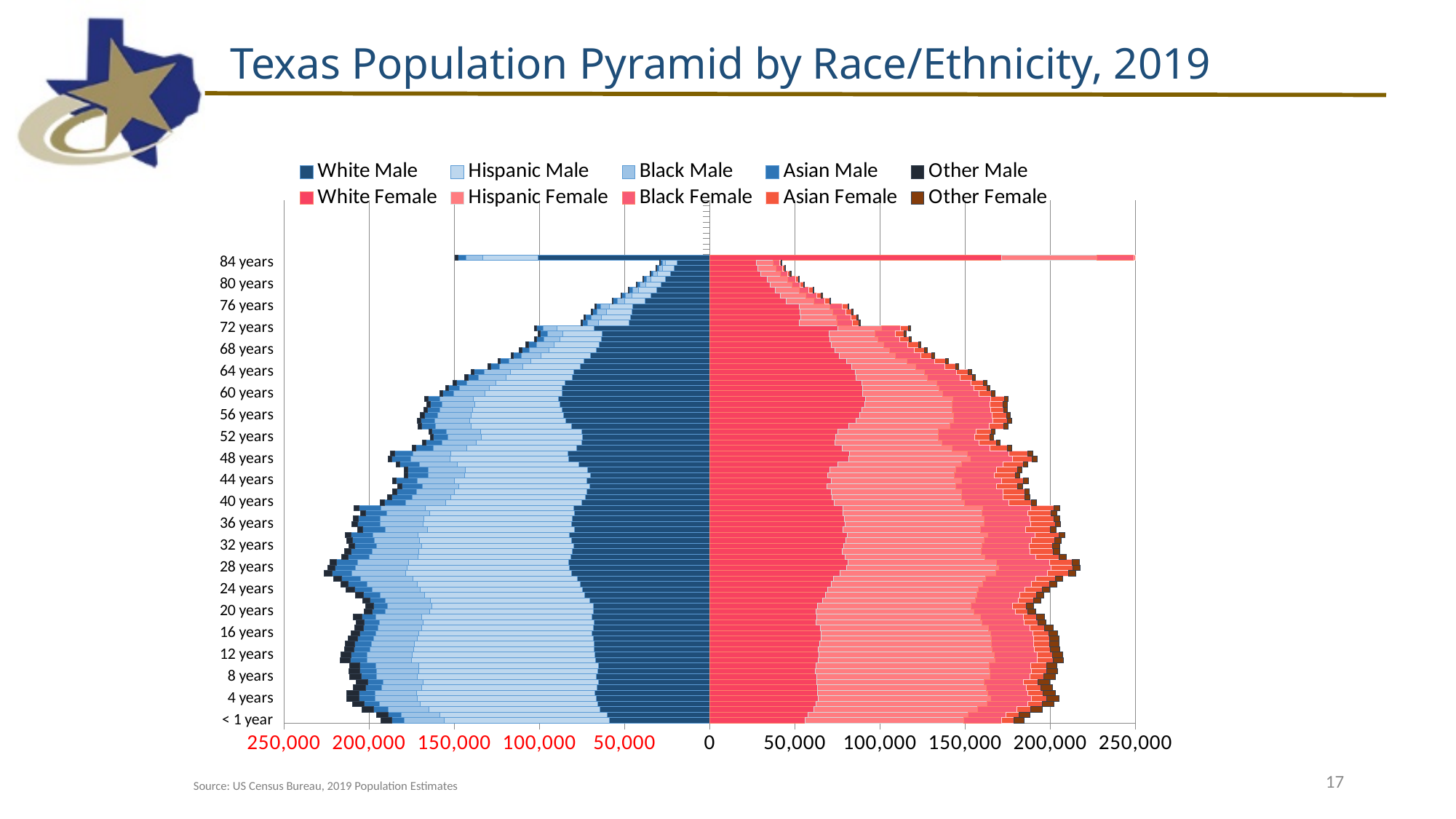
How many series does the legend list? 10 Is the total male bar at 28 years greater or less than 200,000? greater At 84 years, is the total male bar or the total female bar longer? female Which legend entry is shown in dark navy blue? White Male Is the total male bar at 76 years greater or less than 100,000? less Is the total female bar at 56 years greater or less than 150,000? greater What type of chart is shown on the slide? bar chart What is the title of the chart? Texas Population Pyramid by Race/Ethnicity, 2019 How many age labels are shown on the vertical axis? 22 Moving from 40 years up to 80 years, do the total male bars generally get longer or shorter? shorter